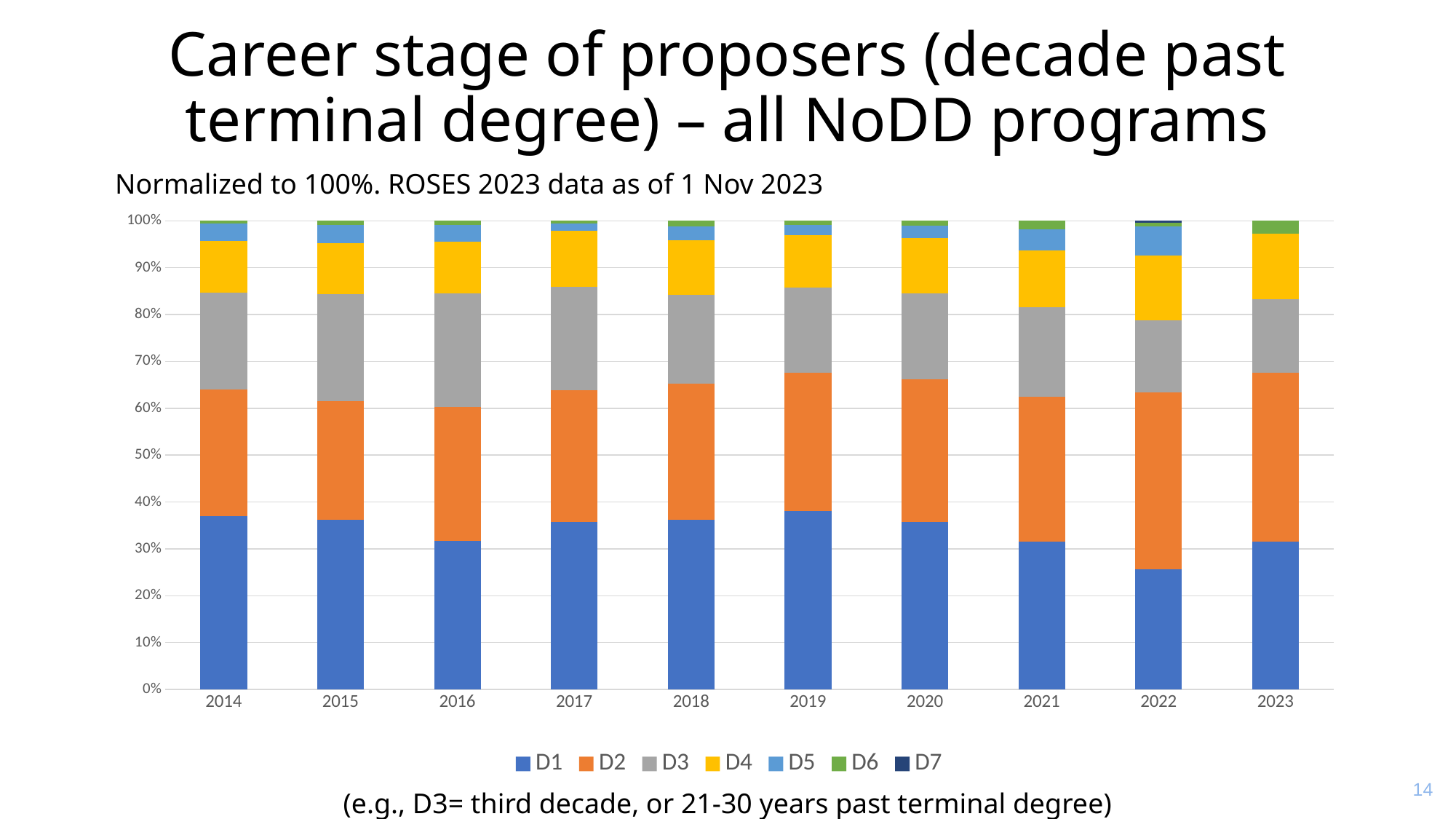
Does the D1 share rise or fall from 2019 to 2022? falls Is the D1 share for 2022 greater or less than 30%? less How many years are shown along the x axis of the chart? 10 What kind of chart is shown on the slide? Stacked bar chart Is the D1 share for 2019 greater or less than 40%? less What colour represents the D1 series in the chart? Blue How many series does the chart's legend list? 7 What is the total height of each stacked bar in the chart? 100% What are the legend entries of the chart, in order? D1, D2, D3, D4, D5, D6, D7 Is the D1 share for 2014 greater or less than 30%? greater Which year has the smallest D1 share? 2022 Which year has the larger D1 share, 2014 or 2022? 2014